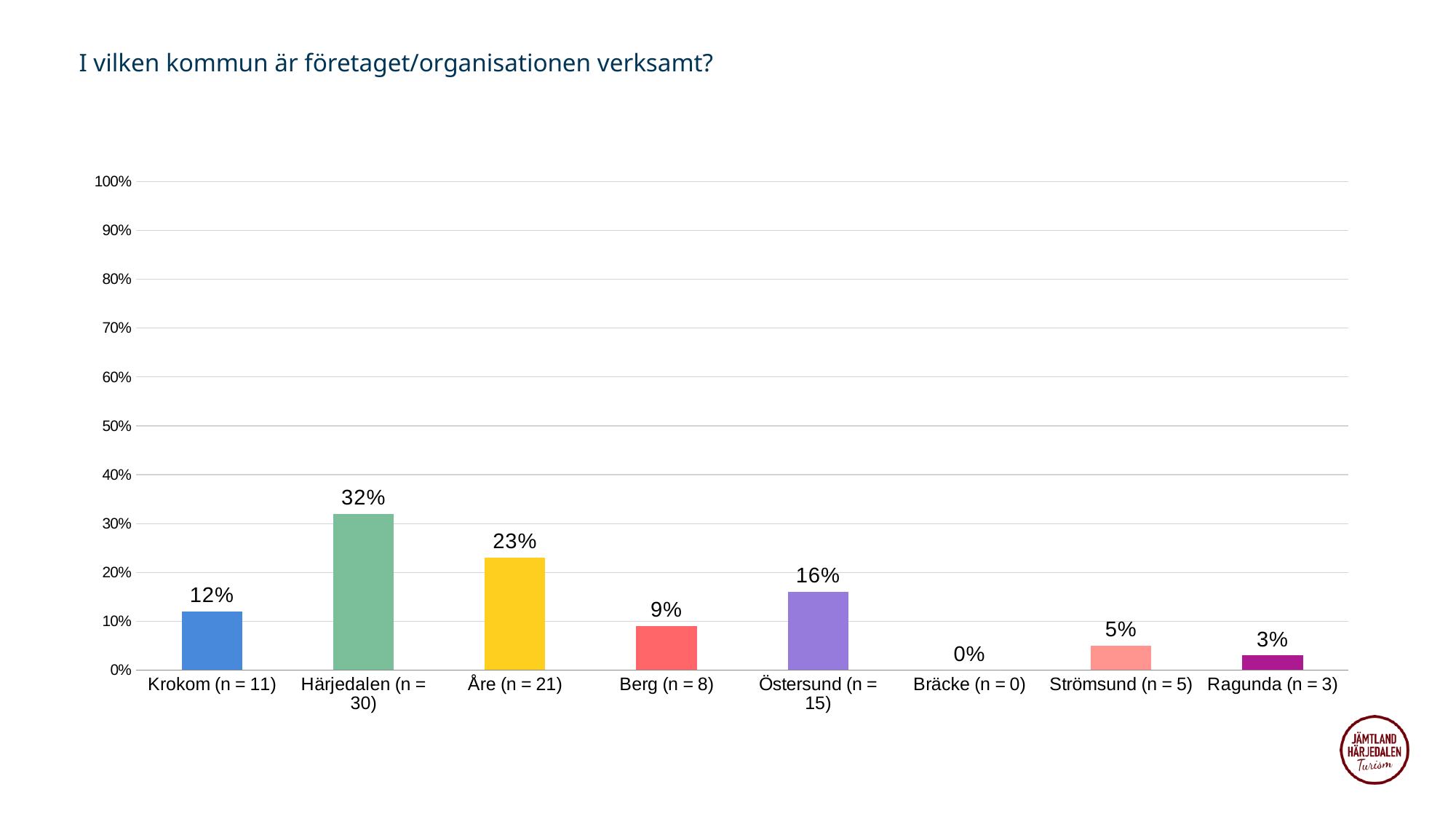
Which is larger, the value for Berg (n = 8) or the value for Östersund (n = 15)? Östersund (n = 15) Which municipality has the lowest value? Bräcke (n = 0) What is the value for Östersund (n = 15)? 16% What kind of chart is shown on the slide? bar chart What is the value for Härjedalen (n = 30)? 32% Which municipality has the highest value? Härjedalen (n = 30) Is the value for Åre (n = 21) greater or less than 20%? greater What is the title of the chart? I vilken kommun är företaget/organisationen verksamt? What is the value for Strömsund (n = 5)? 5% What is the difference between the values for Härjedalen (n = 30) and Åre (n = 21)? 9% How many municipalities are shown on the x axis? 8 What is the difference between the values for Krokom (n = 11) and Ragunda (n = 3)? 9%